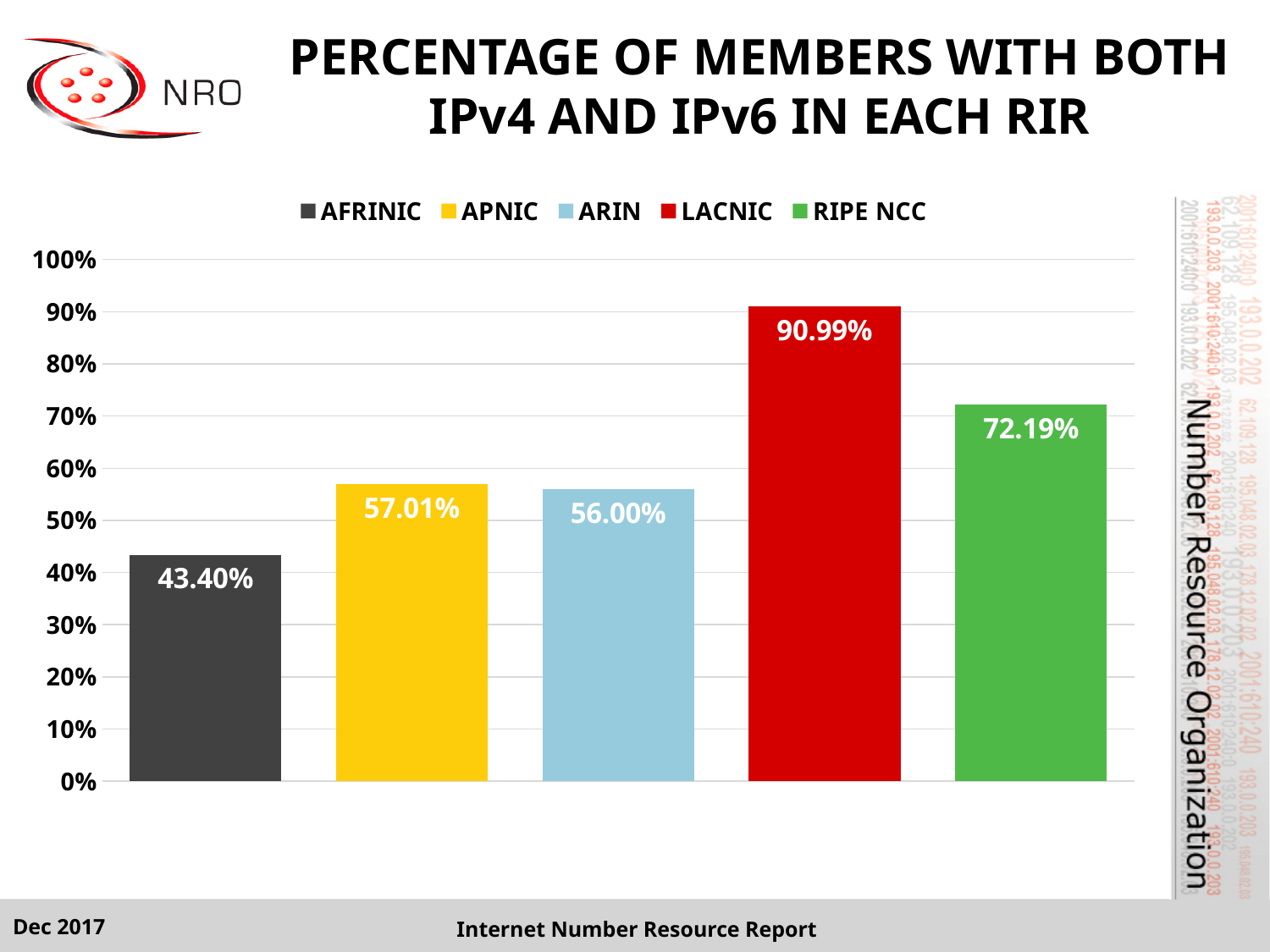
What is the difference in percentage points between APNIC and ARIN? 1.01 How many RIRs are shown in the chart? 5 Is the value for ARIN greater or less than 60%? less Which RIR has the lowest percentage of members with both IPv4 and IPv6? AFRINIC Which RIR has the highest percentage of members with both IPv4 and IPv6? LACNIC What percentage of AFRINIC members have both IPv4 and IPv6? 43.40% What is the value shown for RIPE NCC? 72.19% What is the difference in percentage points between LACNIC and RIPE NCC? 18.80 Which has a higher percentage, RIPE NCC or AFRINIC? RIPE NCC What colour is the bar for LACNIC? red What percentage of LACNIC members have both IPv4 and IPv6? 90.99% What kind of chart is shown on the slide? bar chart